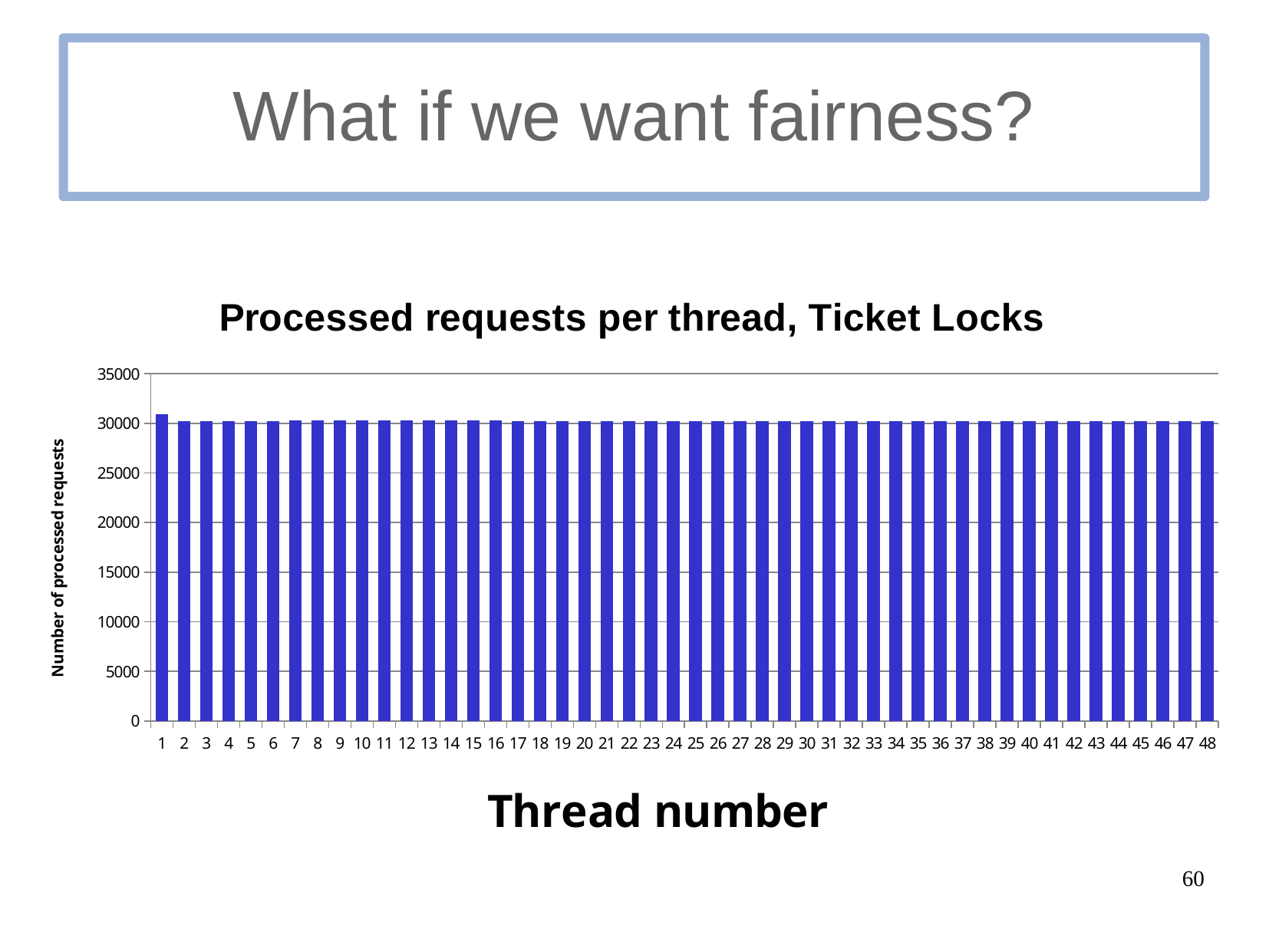
Is the value for thread 10 greater or less than 25000? greater Do the values rise, fall, or stay roughly flat across thread numbers 2 to 48? Stay roughly flat What kind of chart is shown on the slide? Bar chart Is the value for thread 1 greater or less than 30000? greater Which thread has the highest number of processed requests? Thread 1 What is the title of the chart? Processed requests per thread, Ticket Locks Which is larger, the value for thread 1 or the value for thread 2? Thread 1 What is the label of the x axis? Thread number What is the highest value shown on the y axis? 35000 How many threads (bars) are plotted in the chart? 48 Is the value for thread 25 greater or less than 20000? greater